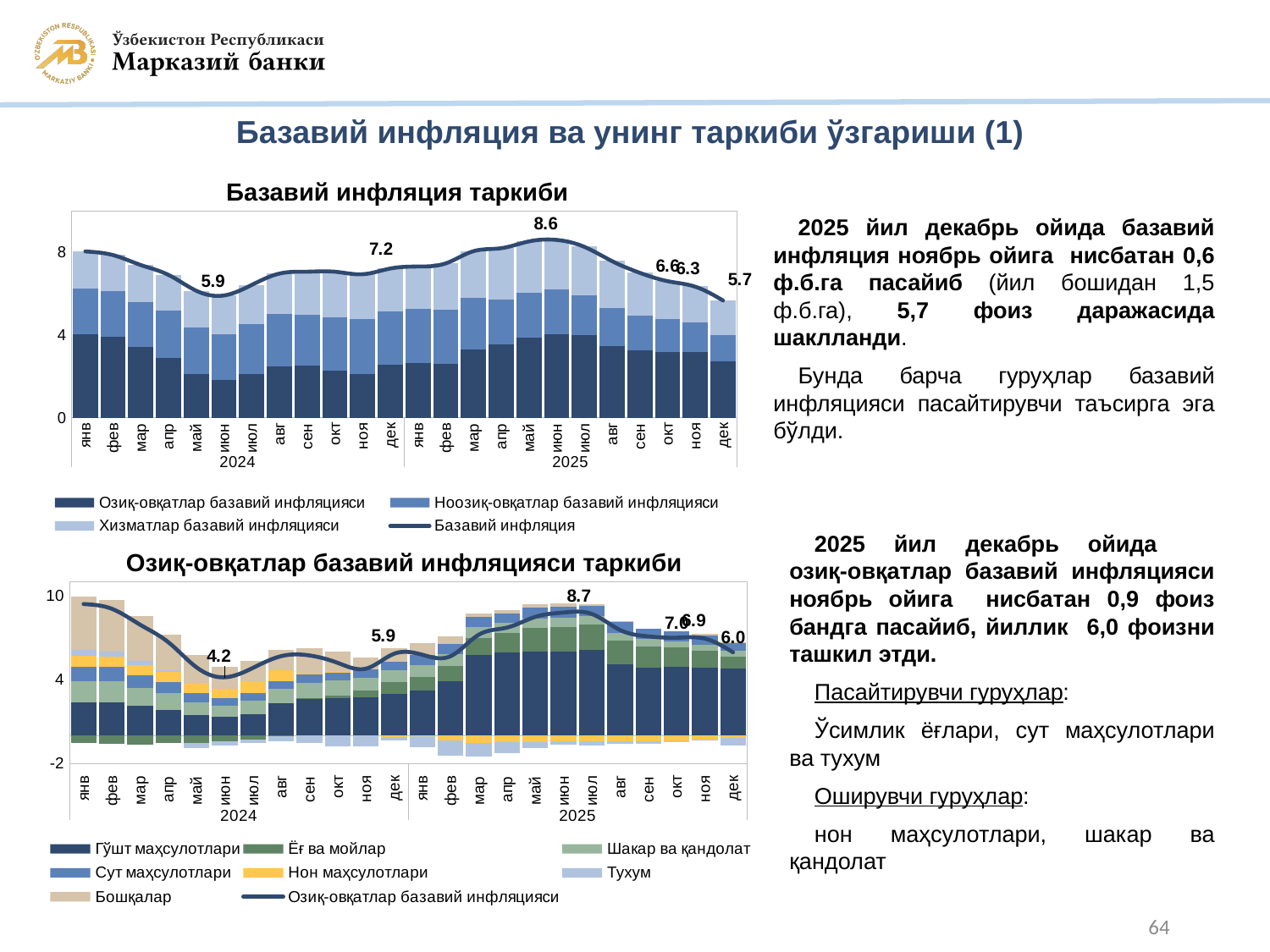
In the chart titled "Озиқ-овқатлар базавий инфляцияси таркиби", how many entries does the legend list? 8 In the chart titled "Озиқ-овқатлар базавий инфляцияси таркиби", what is the labelled value of the line in June 2024? 4.2 In the chart titled "Базавий инфляция таркиби", what is the labelled value of the Базавий инфляция line in December 2025? 5.7 In the chart titled "Озиқ-овқатлар базавий инфляцияси таркиби", which labelled value is larger: December 2024 (5.9) or December 2025 (6.0)? December 2025 (6.0) In the chart titled "Базавий инфляция таркиби", how many entries does the legend list? 4 In the chart titled "Озиқ-овқатлар базавий инфляцияси таркиби", what is the labelled value of the line in December 2025? 6.0 In the chart titled "Базавий инфляция таркиби", what is the labelled value of the Базавий инфляция line in June 2024? 5.9 In the chart titled "Базавий инфляция таркиби", does the Базавий инфляция line rise or fall from June 2025 to December 2025? fall In the chart titled "Базавий инфляция таркиби", what is the difference between the labelled values for June 2025 (8.6) and December 2025 (5.7)? 2.9 What kind of chart is the chart titled "Озиқ-овқатлар базавий инфляцияси таркиби"? Stacked bar chart with a line In the chart titled "Базавий инфляция таркиби", what is the labelled value of the Базавий инфляция line in June 2025? 8.6